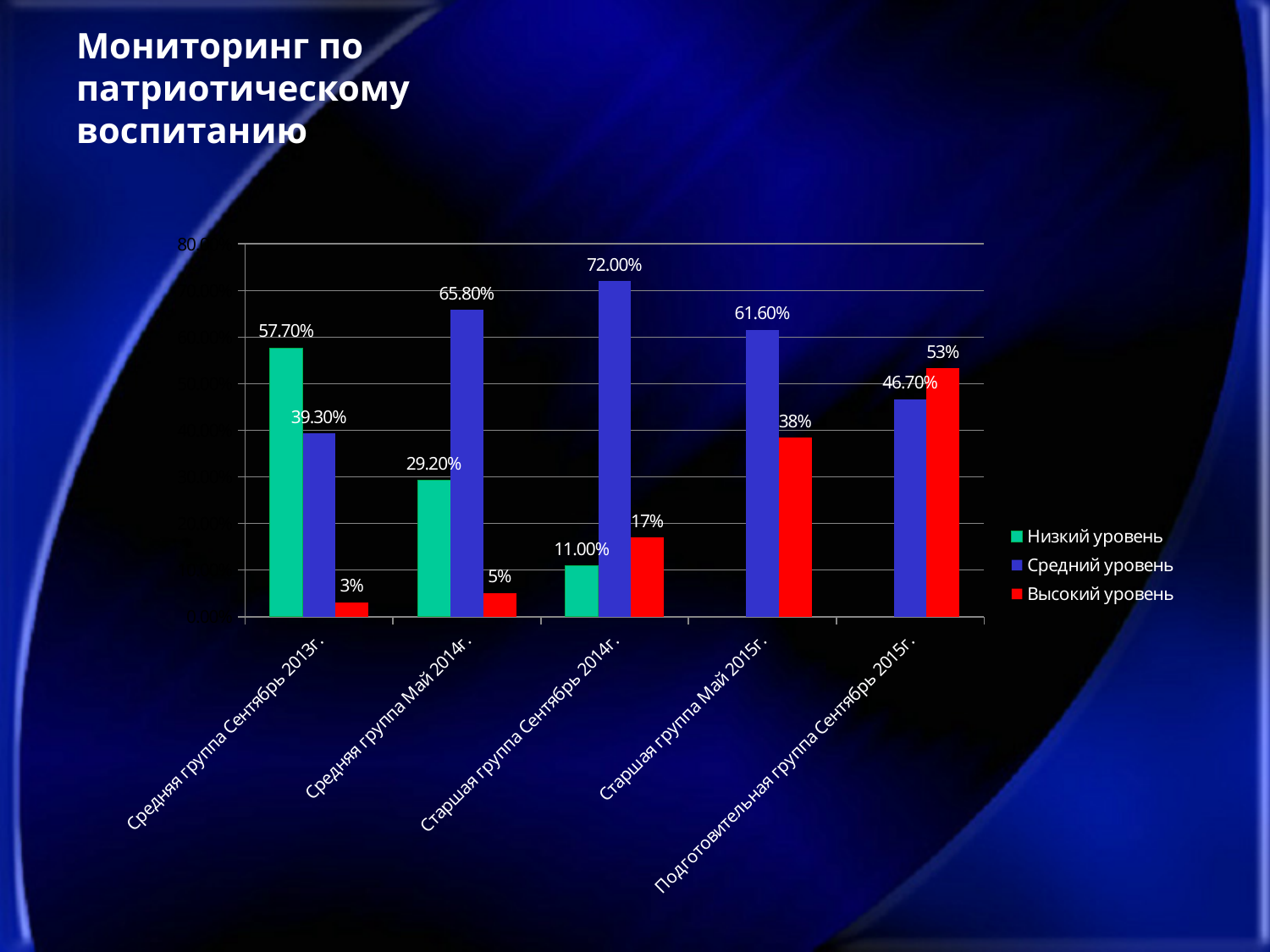
Which category has the highest value for Средний уровень? Старшая группа Сентябрь 2014г. How does the Высокий уровень value change across the categories from left to right? It rises What is the difference between Средний уровень for Средняя группа Май 2014г. (65.80%) and Средняя группа Сентябрь 2013г. (39.30%)? 26.50% How many series does the legend list? 3 Which category has the lowest value for Высокий уровень? Средняя группа Сентябрь 2013г. What is the value of Высокий уровень for Подготовительная группа Сентябрь 2015г.? 53% What is the value of Высокий уровень for Старшая группа Май 2015г.? 38% Which is larger for Подготовительная группа Сентябрь 2015г.: Средний уровень or Высокий уровень? Высокий уровень How many categories are shown on the x axis? 5 What kind of chart is shown on the slide? Bar chart What is the value of Низкий уровень for Средняя группа Сентябрь 2013г.? 57.70% What is the value of Средний уровень for Старшая группа Сентябрь 2014г.? 72.00%